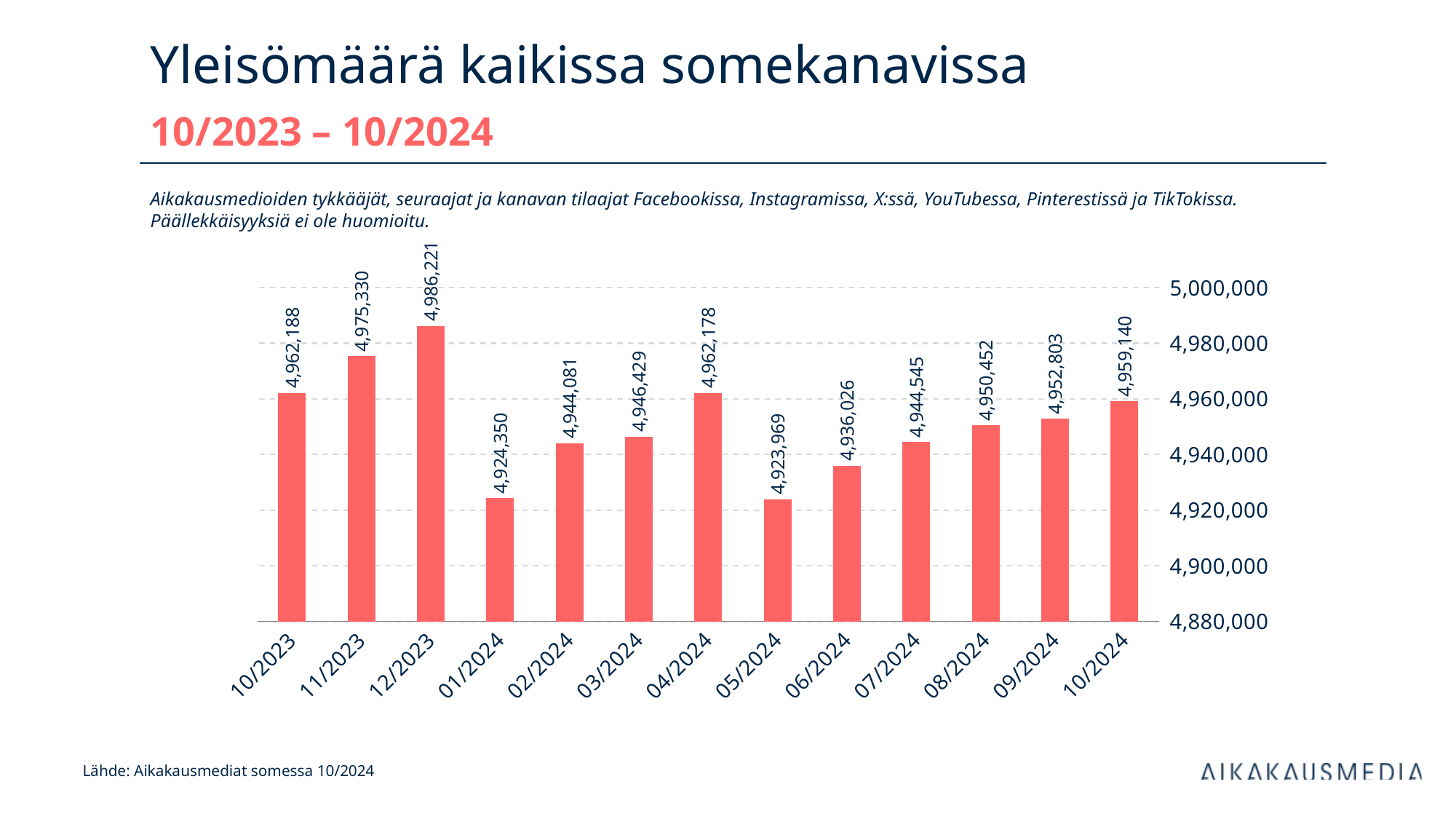
What is the value for 12/2023? 4,986,221 Do the values rise or fall from 05/2024 to 10/2024? rise What is the difference between the values for 12/2023 and 10/2023? 24,033 Is the value for 06/2024 greater or less than 4,940,000? less What is the value for 10/2024? 4,959,140 Which is larger, the value for 10/2023 or the value for 10/2024? 10/2023 What kind of chart is shown on the slide? bar chart How many months are shown on the x axis? 13 What is the difference between the values for 11/2023 and 01/2024? 50,980 Which month has the lowest value? 05/2024 What is the value for 05/2024? 4,923,969 Which month has the highest value? 12/2023